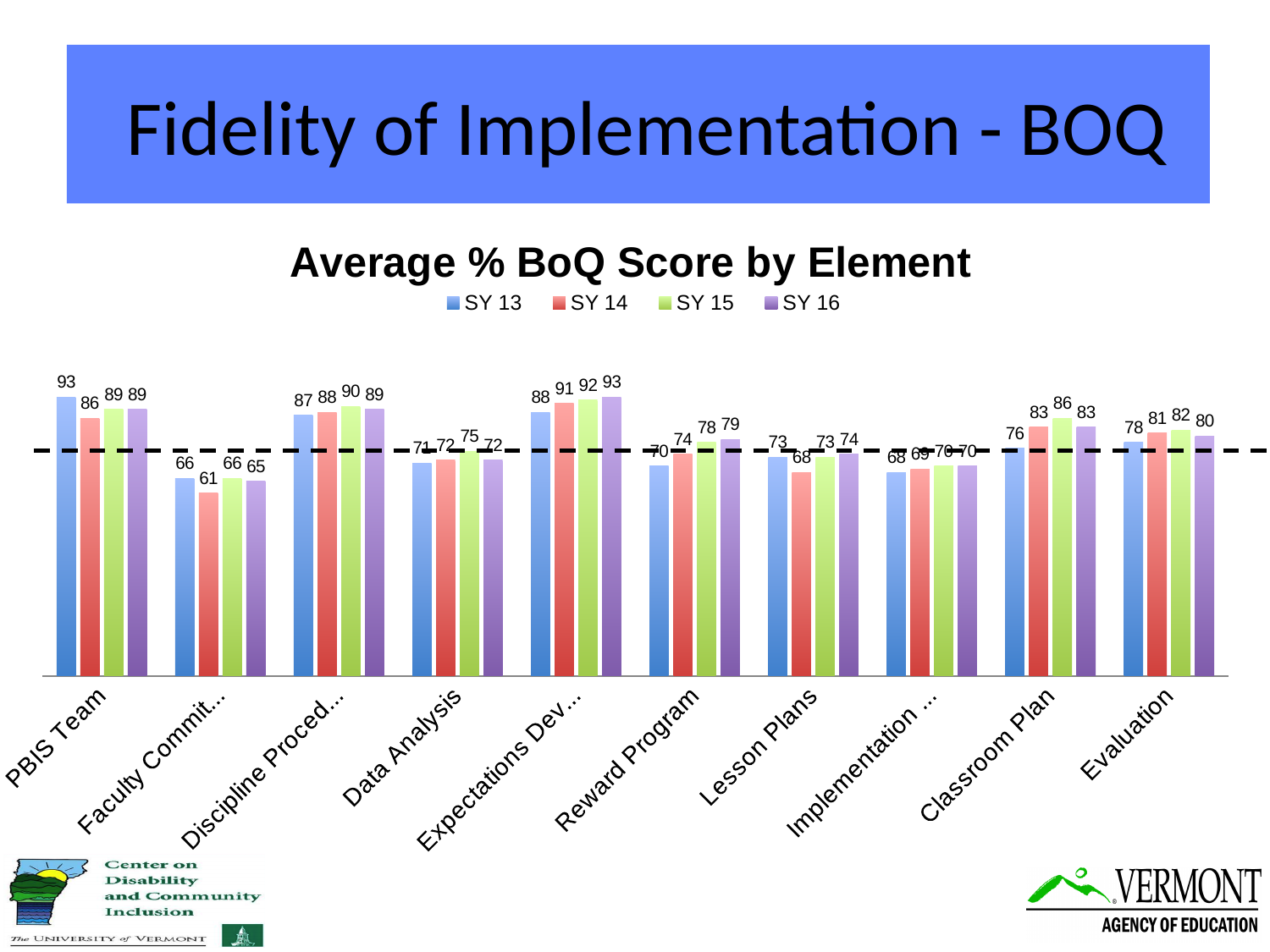
What is the SY 15 value for Classroom Plan? 86 What kind of chart is shown on the slide? Bar chart Which series has the lowest value for Data Analysis? SY 13 Do the Reward Program values rise or fall from SY 13 to SY 16? Rise How many series does the legend list? 4 Which is larger for Evaluation: the SY 15 value or the SY 16 value? SY 15 How many elements (categories) are shown on the x axis? 10 What is the SY 14 value for Lesson Plans? 68 Which element has the highest SY 13 value? PBIS Team What is the SY 13 value for PBIS Team? 93 What is the difference between the SY 13 and SY 14 values for PBIS Team? 7 What is the SY 16 value for Reward Program? 79